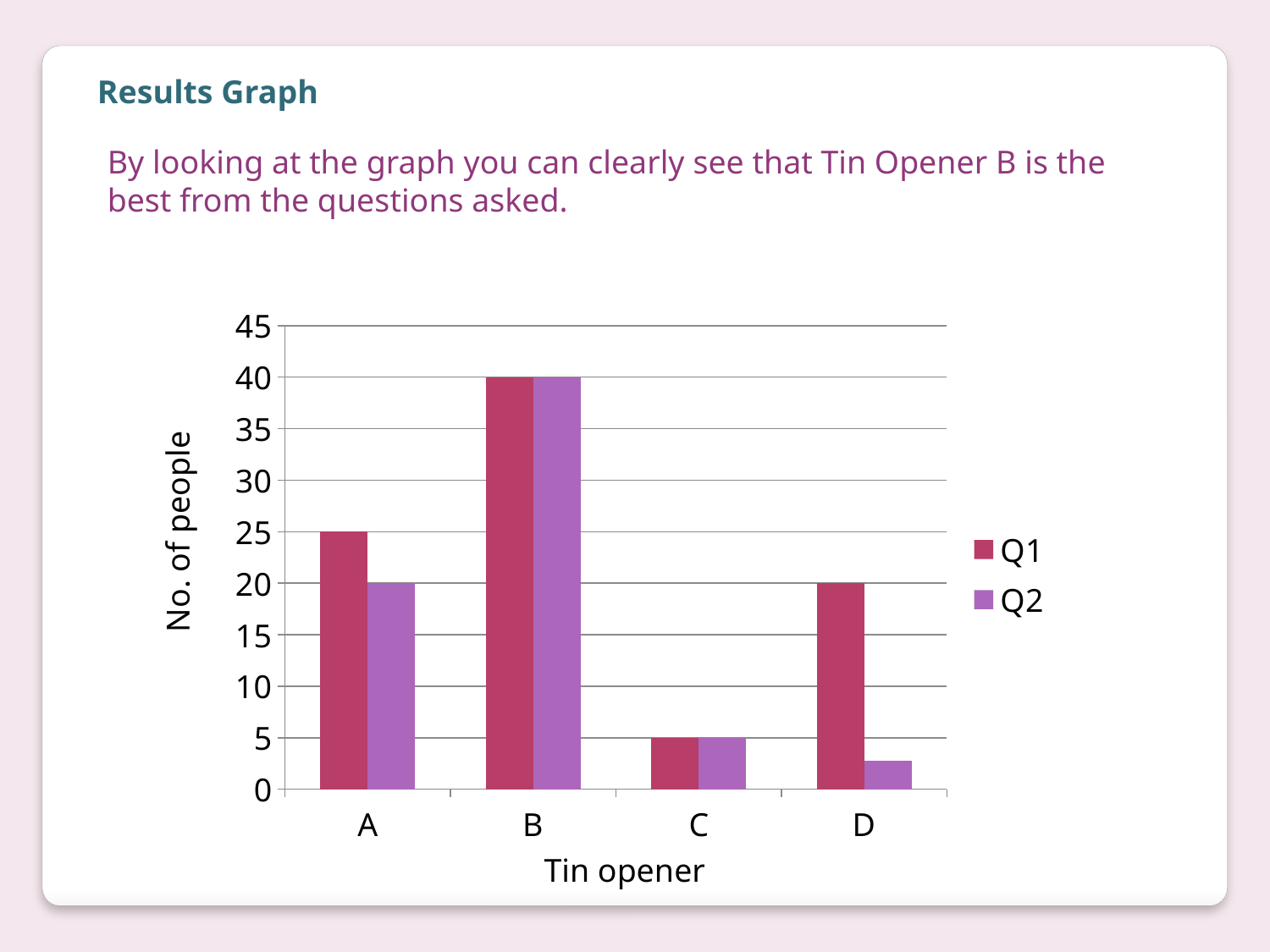
How many tin opener categories are shown on the x axis? 4 Which tin opener has the lowest Q2 value? D How many series does the legend list? 2 What is the label of the y axis? No. of people Is the Q2 value for tin opener D greater or less than 5? less What is the Q1 value for tin opener D? 20 What kind of chart is shown on the slide? bar chart Which tin opener has the highest Q1 value? B What is the difference between the Q1 and Q2 values for tin opener A? 5 Which is larger for tin opener D, the Q1 value or the Q2 value? Q1 What is the Q2 value for tin opener B? 40 What is the Q1 value for tin opener A? 25